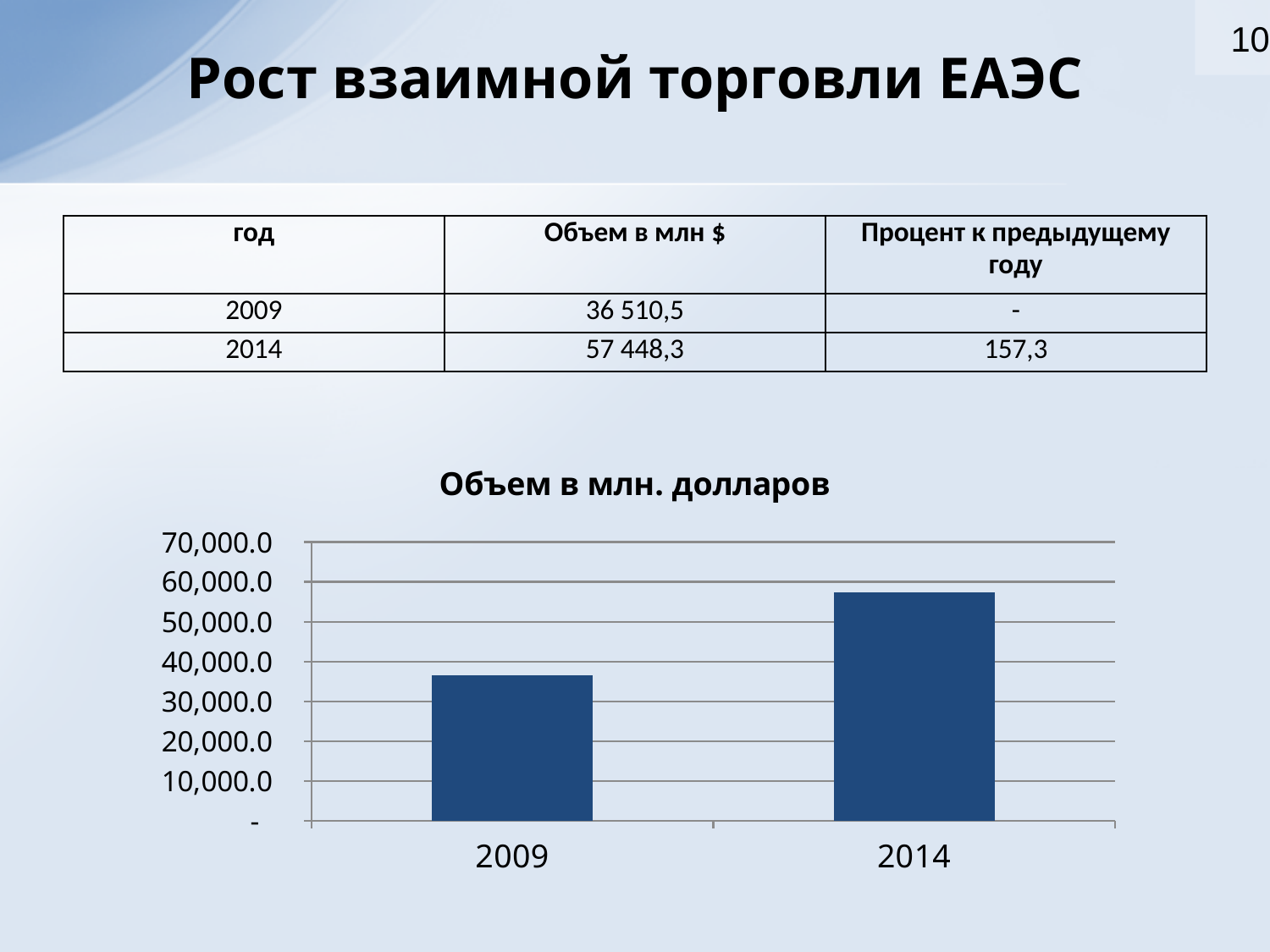
According to the table on the slide, what is the volume in million $ for 2009? 36 510,5 Which year has the higher bar in the chart? 2014 Is the value for 2009 greater or less than 30,000.0? greater How many bars does the chart have? 2 According to the table on the slide, what is the volume in million $ for 2014? 57 448,3 What kind of chart is shown on the slide? bar chart Do the values rise or fall from 2009 to 2014? rise What is the title of the chart? Объем в млн. долларов Which year has the lower bar in the chart? 2009 Is the value for 2009 greater or less than 40,000.0? less Is the value for 2014 greater or less than 60,000.0? less